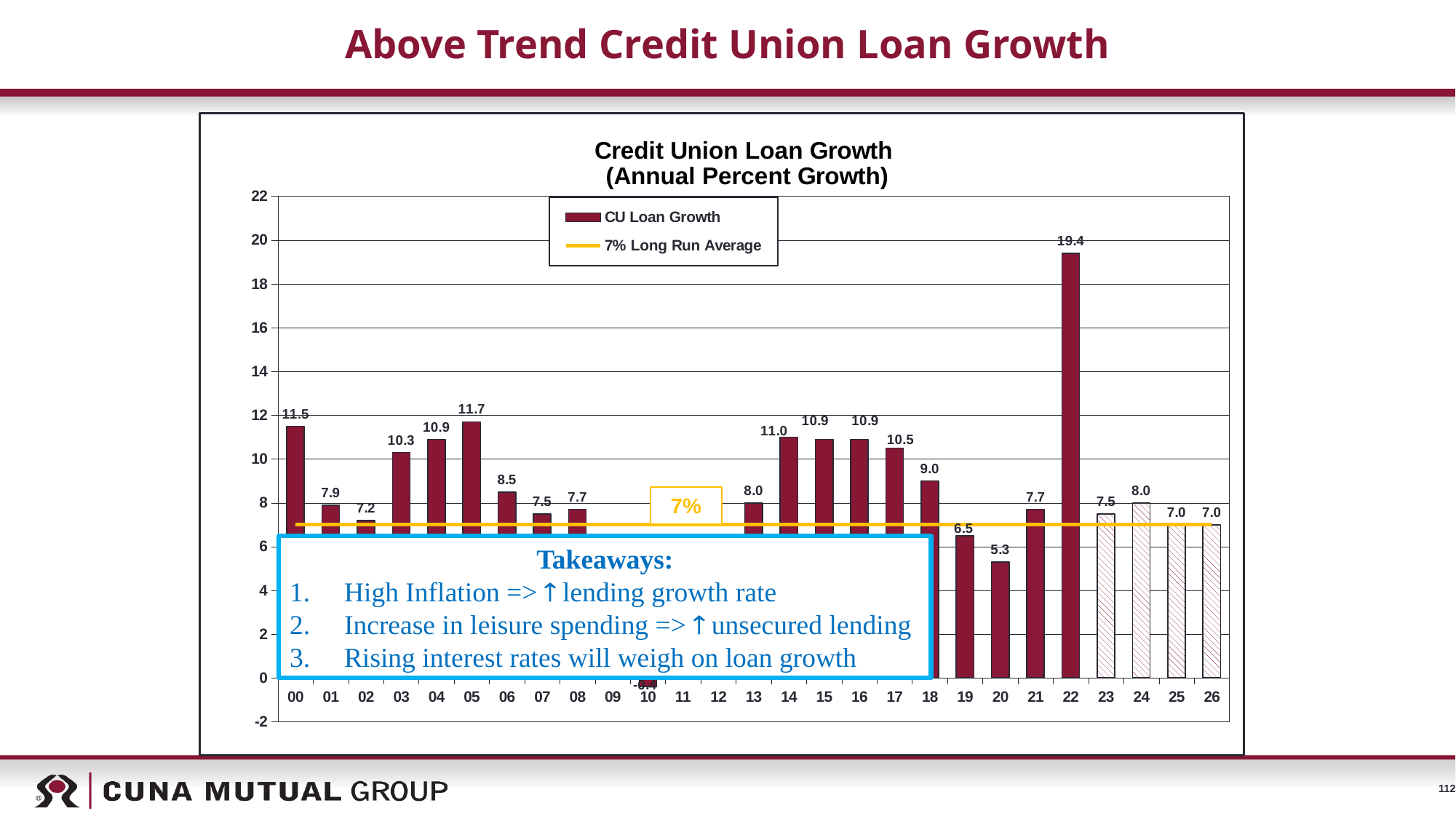
What is the CU Loan Growth value for 05? 11.7 What is the CU Loan Growth value for 22? 19.4 Which year has the highest CU Loan Growth value? 22 What value does the yellow horizontal line represent according to the legend? 7% Long Run Average What is the difference between the CU Loan Growth values for 22 and 21? 11.7 Is the CU Loan Growth value for 10 greater or less than 0? less Which has a larger CU Loan Growth value, 03 or 06? 03 How many series does the legend list? 2 What type of chart is shown on the slide? combination bar and line chart What is the CU Loan Growth value for 20? 5.3 Do the CU Loan Growth values rise or fall from 14 to 20? fall How many years are shown on the x axis? 27